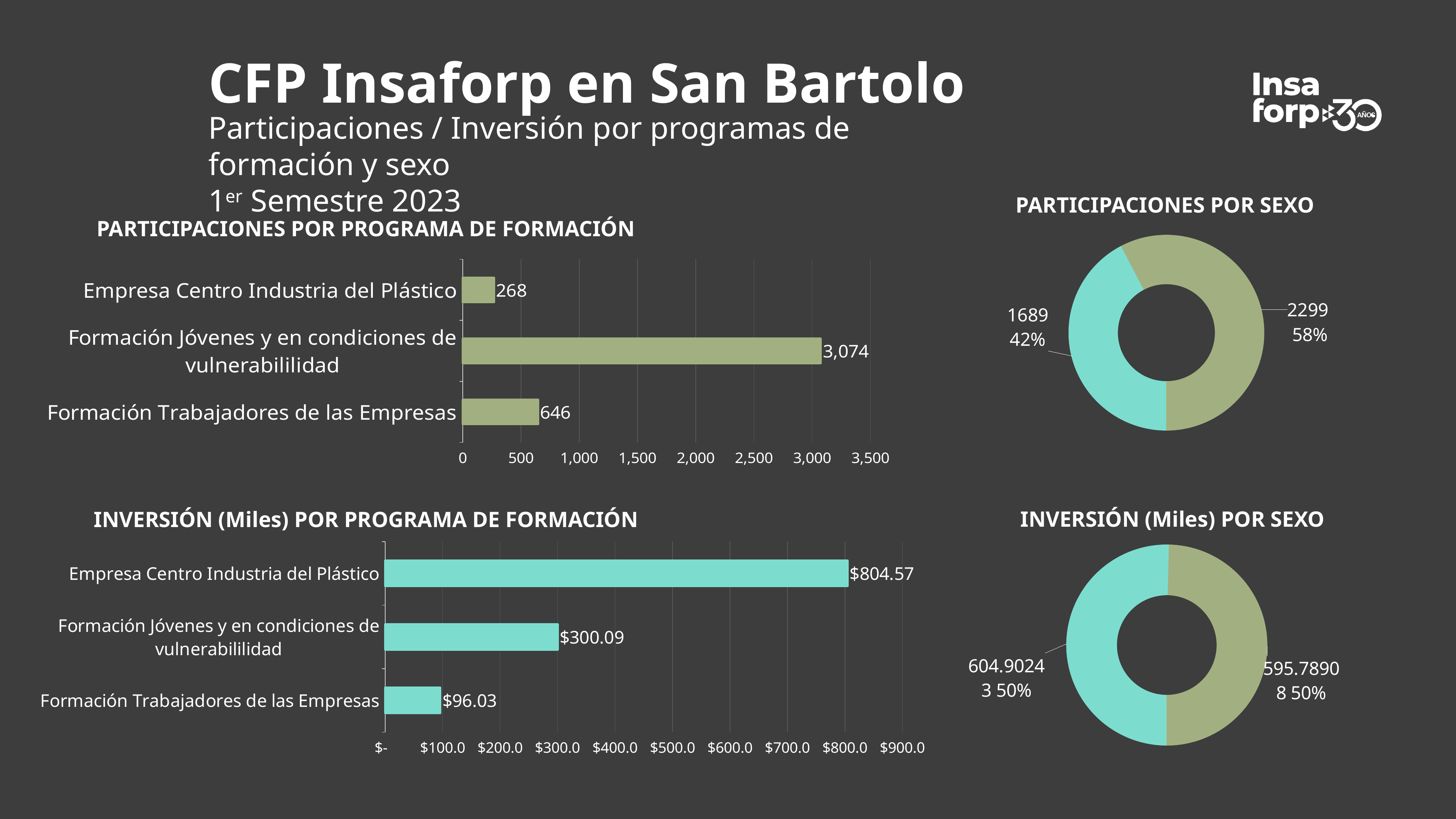
In the chart titled INVERSIÓN (Miles) POR PROGRAMA DE FORMACIÓN, which is larger: Formación Jóvenes y en condiciones de vulnerabililidad or Formación Trabajadores de las Empresas? Formación Jóvenes y en condiciones de vulnerabililidad In the chart titled PARTICIPACIONES POR PROGRAMA DE FORMACIÓN, what is the value for Empresa Centro Industria del Plástico? 268 In the chart titled INVERSIÓN (Miles) POR PROGRAMA DE FORMACIÓN, which program has the highest value? Empresa Centro Industria del Plástico What kind of chart is the one titled PARTICIPACIONES POR PROGRAMA DE FORMACIÓN? Bar chart In the chart titled INVERSIÓN (Miles) POR PROGRAMA DE FORMACIÓN, what is the value for Formación Trabajadores de las Empresas? $96.03 In the chart titled PARTICIPACIONES POR PROGRAMA DE FORMACIÓN, what is the difference between Formación Trabajadores de las Empresas and Empresa Centro Industria del Plástico? 378 In the chart titled PARTICIPACIONES POR SEXO, what is the value of the slice with the 42% share? 1689 How many categories are shown in the chart titled INVERSIÓN (Miles) POR PROGRAMA DE FORMACIÓN? 3 In the chart titled INVERSIÓN (Miles) POR PROGRAMA DE FORMACIÓN, what is the value for Empresa Centro Industria del Plástico? $804.57 In the chart titled PARTICIPACIONES POR SEXO, what percentage share does the slice labelled 2299 have? 58% In the chart titled PARTICIPACIONES POR PROGRAMA DE FORMACIÓN, what is the value for Formación Jóvenes y en condiciones de vulnerabililidad? 3,074 In the chart titled PARTICIPACIONES POR PROGRAMA DE FORMACIÓN, which program has the lowest value? Empresa Centro Industria del Plástico